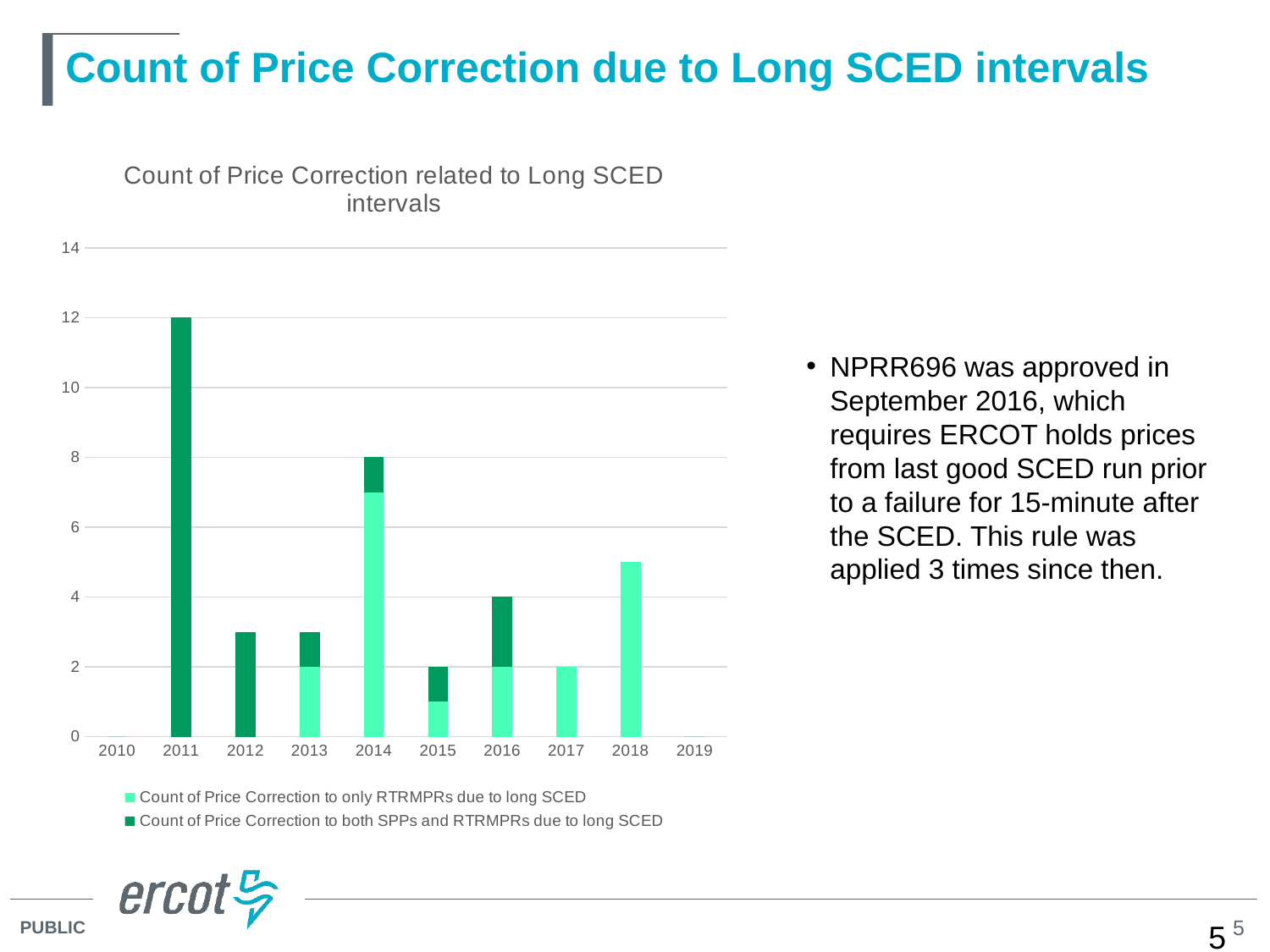
What is the total count of price corrections for 2011? 12 What is the title of the chart? Count of Price Correction related to Long SCED intervals What is the total count of price corrections for 2016? 4 What is the difference between the total counts for 2011 and 2014? 4 Is the total count for 2018 greater or less than 4? greater What kind of chart is shown on the slide? bar chart Which series is shown in the darker green colour? Count of Price Correction to both SPPs and RTRMPRs due to long SCED Which year has the highest total count of price corrections? 2011 How many years are shown on the x axis of the chart? 10 How many series does the chart legend list? 2 What is the total count of price corrections for 2014? 8 Which year has a larger total count, 2011 or 2014? 2011